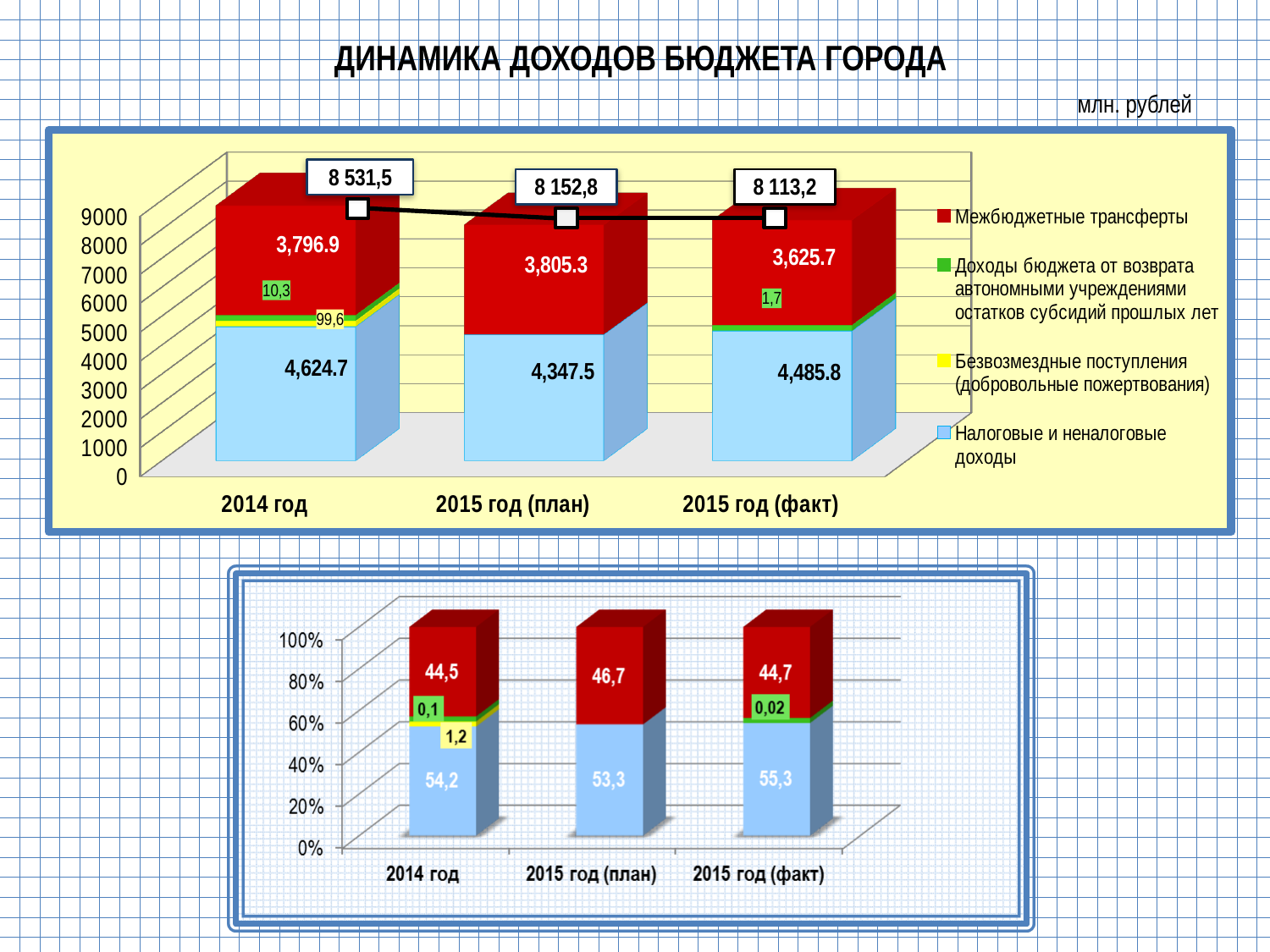
In the top chart, how many series does the legend list? 4 In the top chart, how much larger is Налоговые и неналоговые доходы for 2015 год (факт) than for 2015 год (план)? 138.3 In the top chart, do the total budget income values rise or fall from 2014 год to 2015 год (факт)? fall In the top chart, which year has the highest total budget income? 2014 год What kind of chart is the bottom chart? bar chart In the top chart, is Межбюджетные трансферты larger for 2014 год or for 2015 год (план)? 2015 год (план) In the bottom chart, what is the share of Налоговые и неналоговые доходы (light blue segment) for 2015 год (факт)? 55,3 In the top chart, what is the value of Межбюджетные трансферты for 2015 год (факт)? 3,625.7 In the top chart, what is the value of Налоговые и неналоговые доходы for 2014 год? 4,624.7 In the bottom chart, what is the value of the red segment (Межбюджетные трансферты) for 2015 год (план)? 46,7 In the top chart, how many year categories are shown on the x axis? 3 In the top chart, what is the total budget income shown for 2014 год? 8 531,5